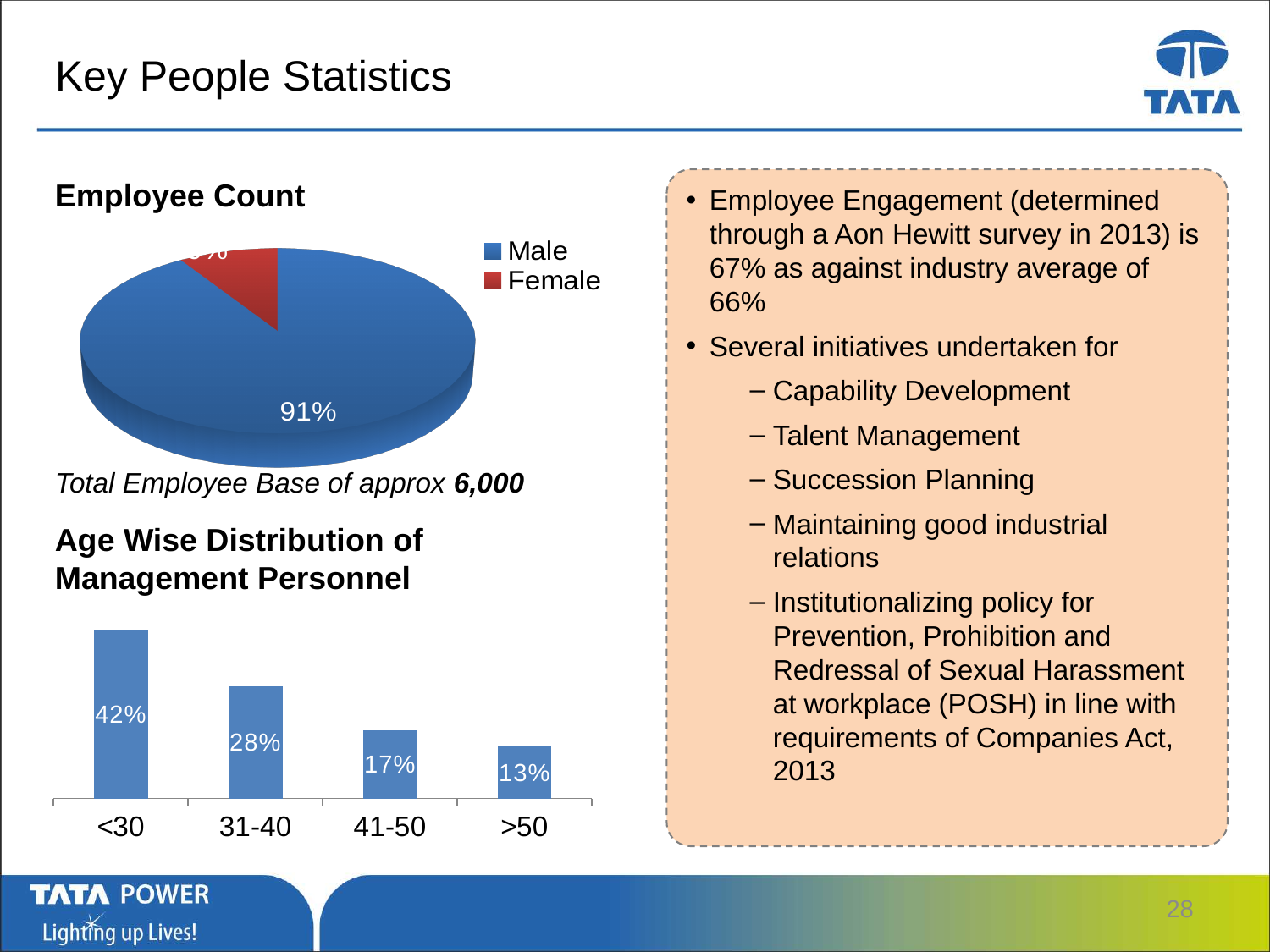
What kind of chart is the Employee Count chart? pie chart In the Employee Count chart, what colour is the Female slice? red In the Employee Count chart, what share of employees is Male? 91% In the Age Wise Distribution of Management Personnel chart, what is the value for the <30 age group? 42% In the Age Wise Distribution of Management Personnel chart, do the values rise or fall from left to right along the x axis? fall In the Age Wise Distribution of Management Personnel chart, which age group has the lowest value? >50 In the Age Wise Distribution of Management Personnel chart, what is the value for the 41-50 age group? 17% In the Age Wise Distribution of Management Personnel chart, what is the difference between the <30 and 31-40 age groups? 14% How many series does the legend of the Employee Count chart list? 2 In the Employee Count chart, which category has the largest slice? Male In the Age Wise Distribution of Management Personnel chart, how many age groups are shown? 4 In the Age Wise Distribution of Management Personnel chart, which age group has the highest value? <30